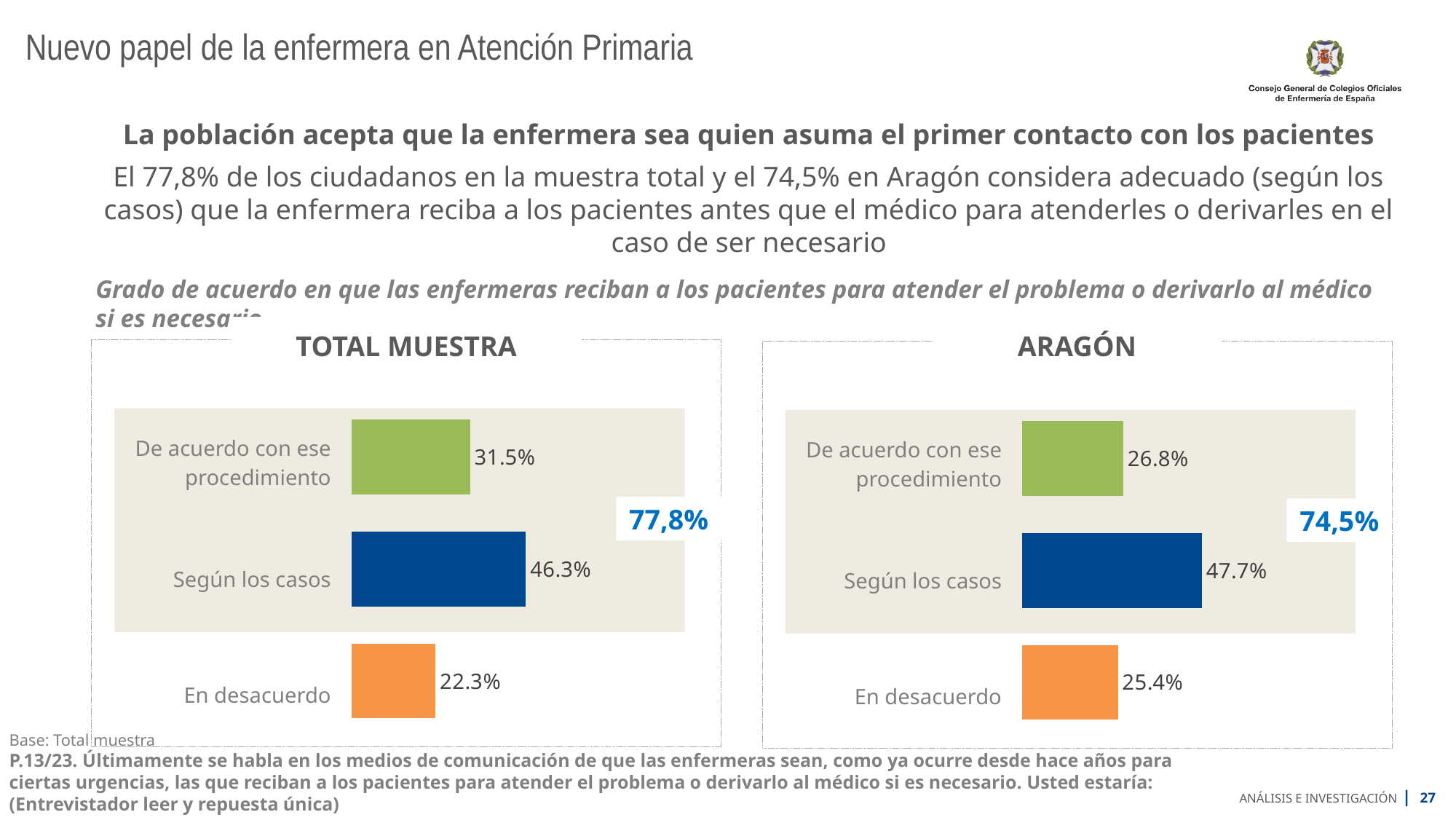
Is the value for 'En desacuerdo' larger in the TOTAL MUESTRA chart or in the ARAGÓN chart? ARAGÓN In the TOTAL MUESTRA chart, what is the value for 'Según los casos'? 46.3% In the TOTAL MUESTRA chart, what is the value for 'De acuerdo con ese procedimiento'? 31.5% In the ARAGÓN chart, what is the combined total of 'De acuerdo con ese procedimiento' and 'Según los casos' as highlighted on the slide? 74,5% In the TOTAL MUESTRA chart, what is the combined total of 'De acuerdo con ese procedimiento' and 'Según los casos' as highlighted on the slide? 77,8% What type of chart is the ARAGÓN chart? Bar chart In the TOTAL MUESTRA chart, which category has the lowest value? En desacuerdo In the ARAGÓN chart, what is the value for 'En desacuerdo'? 25.4% In the TOTAL MUESTRA chart, how many categories are shown? 3 In the TOTAL MUESTRA chart, what colour is the bar for 'En desacuerdo'? Orange In the ARAGÓN chart, what is the difference between 'Según los casos' and 'De acuerdo con ese procedimiento'? 20.9% In the ARAGÓN chart, which category has the highest value? Según los casos